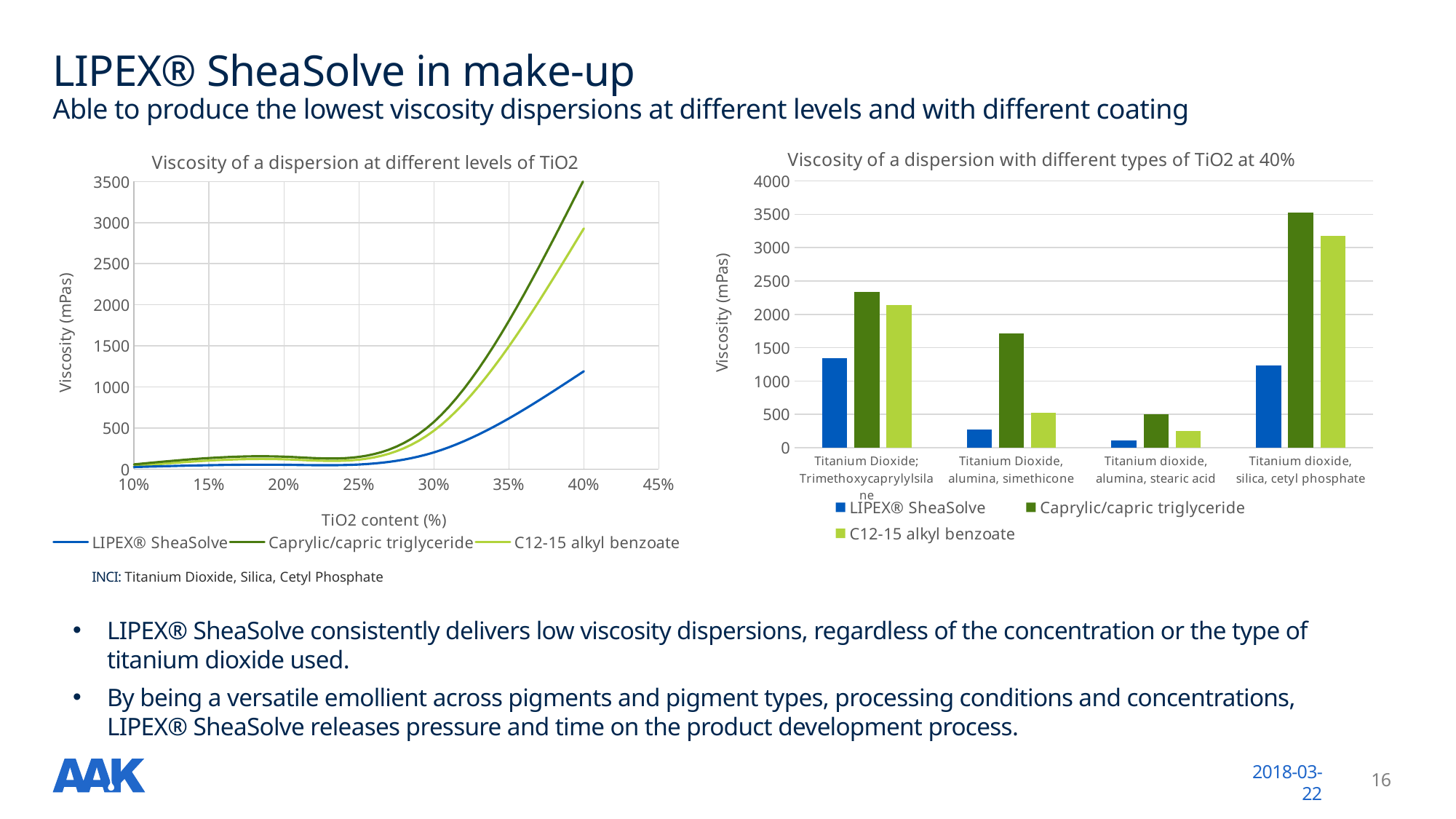
In the left chart, 'Viscosity of a dispersion at different levels of TiO2', which series has the lowest viscosity at 40% TiO2 content? LIPEX® SheaSolve In the left chart, 'Viscosity of a dispersion at different levels of TiO2', do the viscosity values rise or fall as TiO2 content increases from 25% to 40%? rise What kind of chart is the left chart, 'Viscosity of a dispersion at different levels of TiO2'? line chart In the right chart, 'Viscosity of a dispersion with different types of TiO2 at 40%', which is larger for 'Titanium Dioxide, alumina, simethicone': LIPEX® SheaSolve or Caprylic/capric triglyceride? Caprylic/capric triglyceride In the left chart, 'Viscosity of a dispersion at different levels of TiO2', is the viscosity of LIPEX® SheaSolve at 40% TiO2 content greater or less than 1500? less In the right chart, 'Viscosity of a dispersion with different types of TiO2 at 40%', which series has the highest bar for 'Titanium dioxide, silica, cetyl phosphate'? Caprylic/capric triglyceride How many TiO2 type categories are shown on the x axis of the right chart, 'Viscosity of a dispersion with different types of TiO2 at 40%'? 4 What kind of chart is the right chart, 'Viscosity of a dispersion with different types of TiO2 at 40%'? bar chart In the right chart, 'Viscosity of a dispersion with different types of TiO2 at 40%', is the LIPEX® SheaSolve value for 'Titanium Dioxide, alumina, simethicone' greater or less than 500? less How many series does the legend of the left chart, 'Viscosity of a dispersion at different levels of TiO2', list? 3 What is the x-axis title of the left chart, 'Viscosity of a dispersion at different levels of TiO2'? TiO2 content (%) In the left chart, 'Viscosity of a dispersion at different levels of TiO2', which series has the highest viscosity at 40% TiO2 content? Caprylic/capric triglyceride